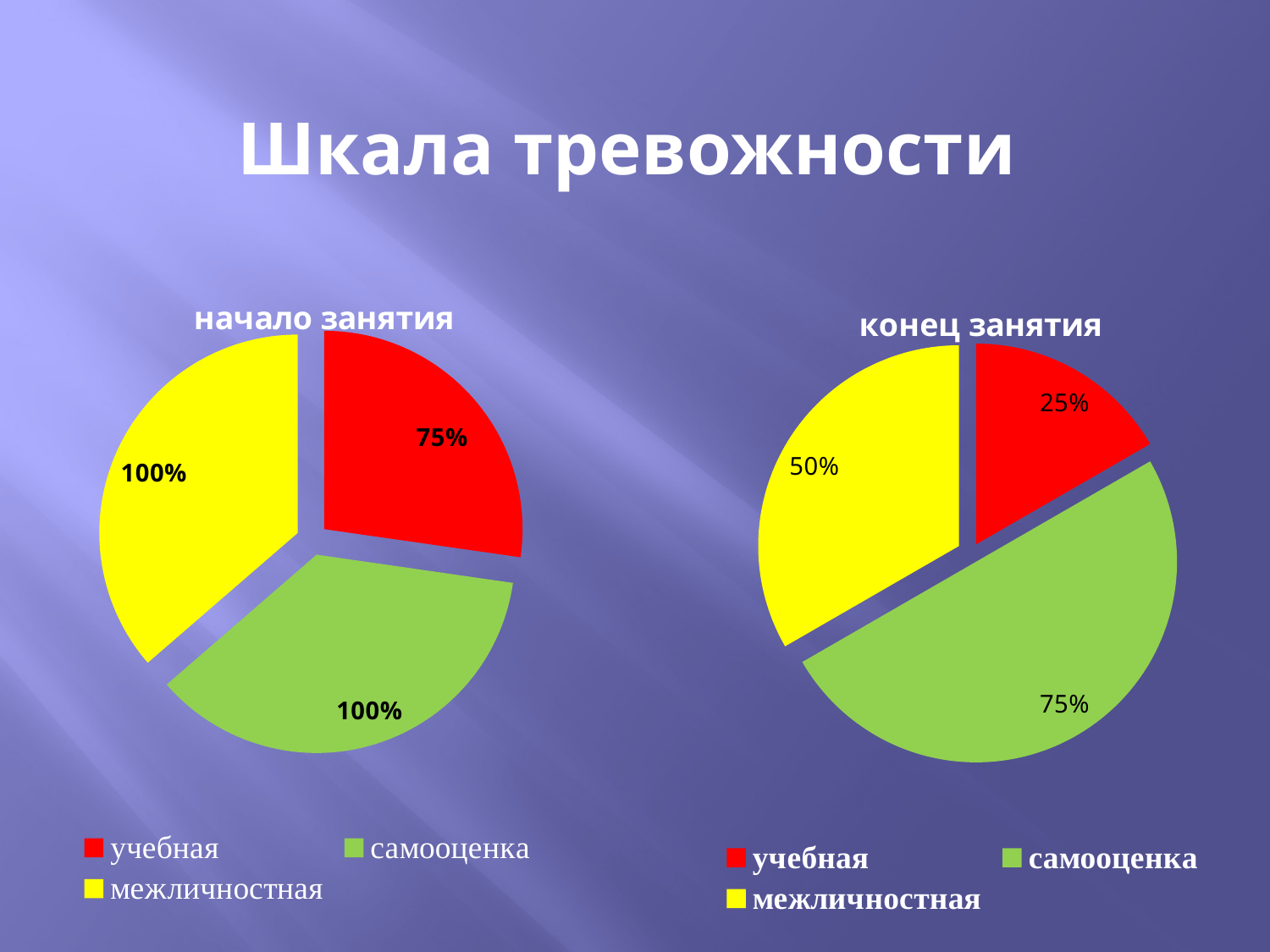
In the "конец занятия" chart, which category has the smallest slice? учебная In the "начало занятия" chart, what value is shown for учебная? 75% In the "начало занятия" chart, which colour represents межличностная? yellow What type of chart is used for "начало занятия"? pie chart In the "конец занятия" chart, what value is shown for учебная? 25% In the "начало занятия" chart, what value is shown for межличностная? 100% In the "начало занятия" chart, what value is shown for самооценка? 100% In the "конец занятия" chart, what value is shown for межличностная? 50% In the "конец занятия" chart, which category has the largest slice? самооценка In the "конец занятия" chart, what value is shown for самооценка? 75% How many categories does the legend of the "начало занятия" chart list? 3 In the "конец занятия" chart, what is the difference between the values for самооценка and учебная? 50%